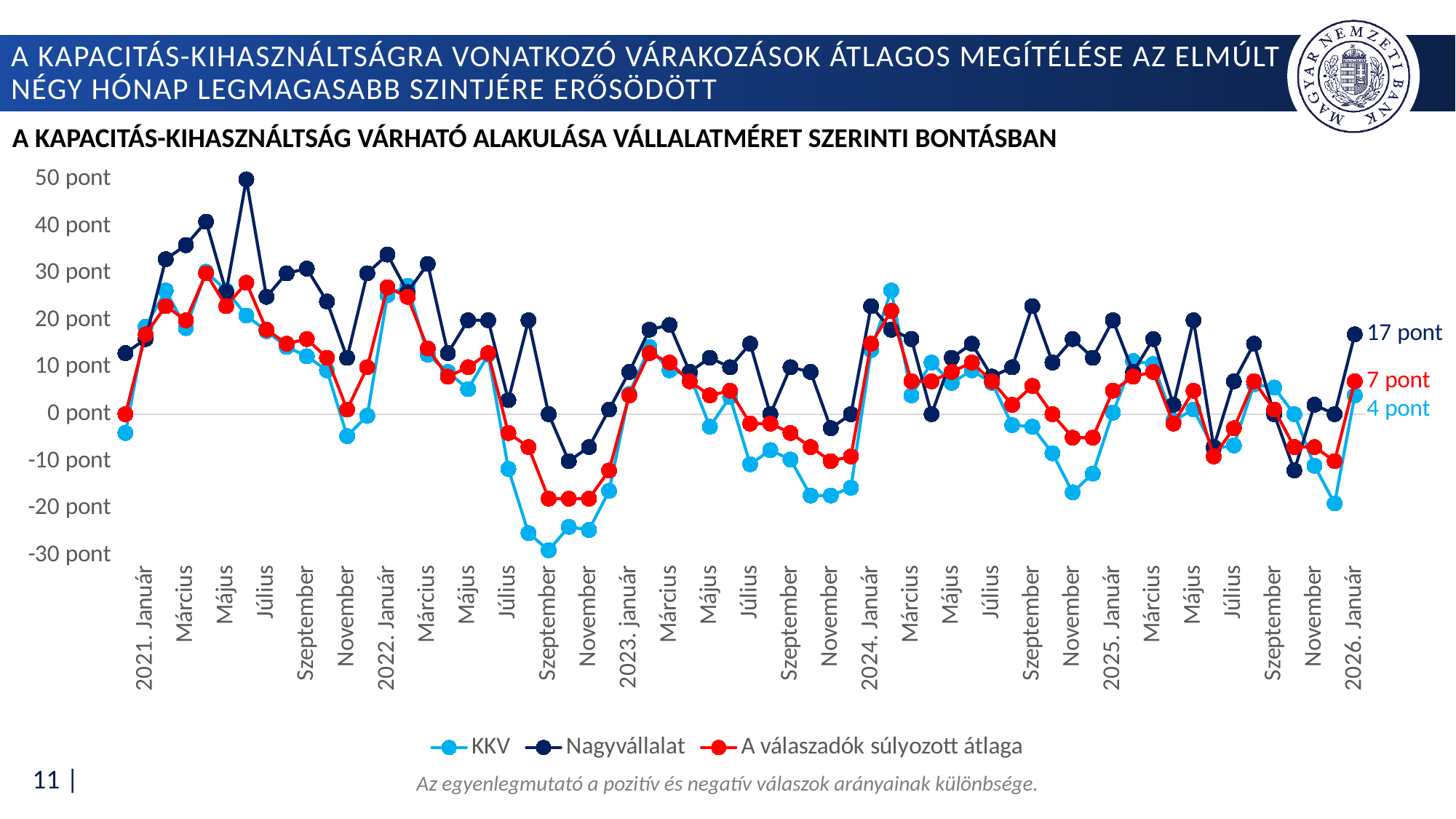
How many series does the legend list? 3 What is the value for A válaszadók súlyozott átlaga in 2026. Január? 7 pont In 2026. Január, which is larger: the Nagyvállalat value or the A válaszadók súlyozott átlaga value? Nagyvállalat Which series has the highest value in 2026. Január? Nagyvállalat What is the title of the chart? A kapacitás-kihasználtság várható alakulása vállalatméret szerinti bontásban Is the Nagyvállalat value in 2021 Március greater or less than 30 pont? greater What is the difference between the Nagyvállalat and KKV values in 2026. Január? 13 pont What is the value for KKV in 2026. Január? 4 pont Which series has the lowest value in 2026. Január? KKV Is the KKV value in 2022 Szeptember greater or less than -20 pont? less What kind of chart is shown on the slide? Line chart What is the value for Nagyvállalat in 2026. Január? 17 pont